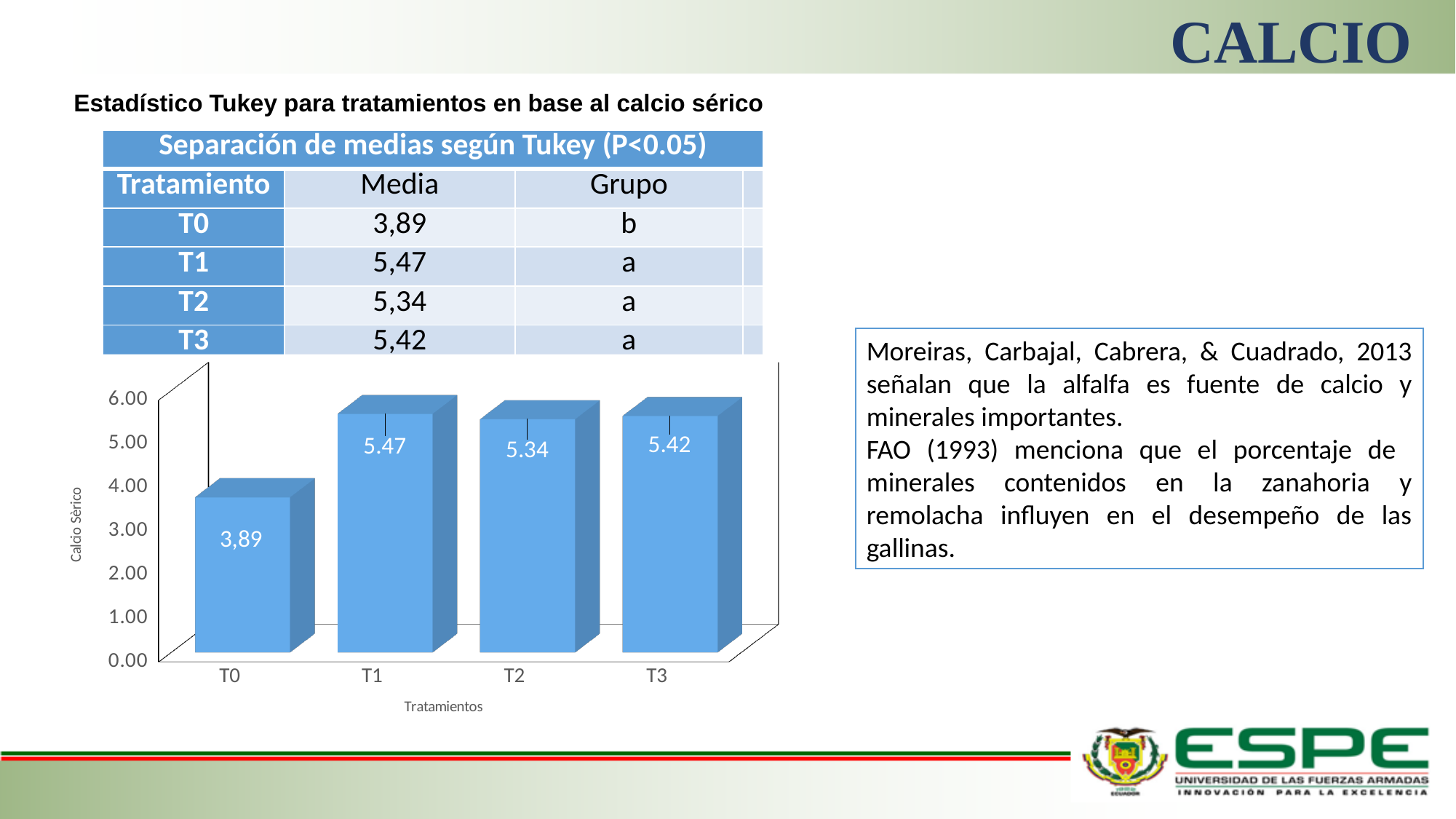
Is the value for T0 in the bar chart greater or less than 4.00? less How many treatments are shown on the x axis of the bar chart? 4 What is the value shown for T3 in the bar chart? 5.42 What kind of chart is shown on the slide? bar chart What is the value shown for T2 in the bar chart? 5.34 What is the value shown for T1 in the bar chart? 5.47 Which treatment has the lowest value in the bar chart? T0 What is the title of the vertical axis of the bar chart? Calcio Sérico Which treatment has the highest value in the bar chart? T1 What is the value shown for T0 in the bar chart? 3,89 What is the difference between the values for T1 and T2 in the bar chart? 0.13 Which has a larger value in the bar chart, T0 or T3? T3